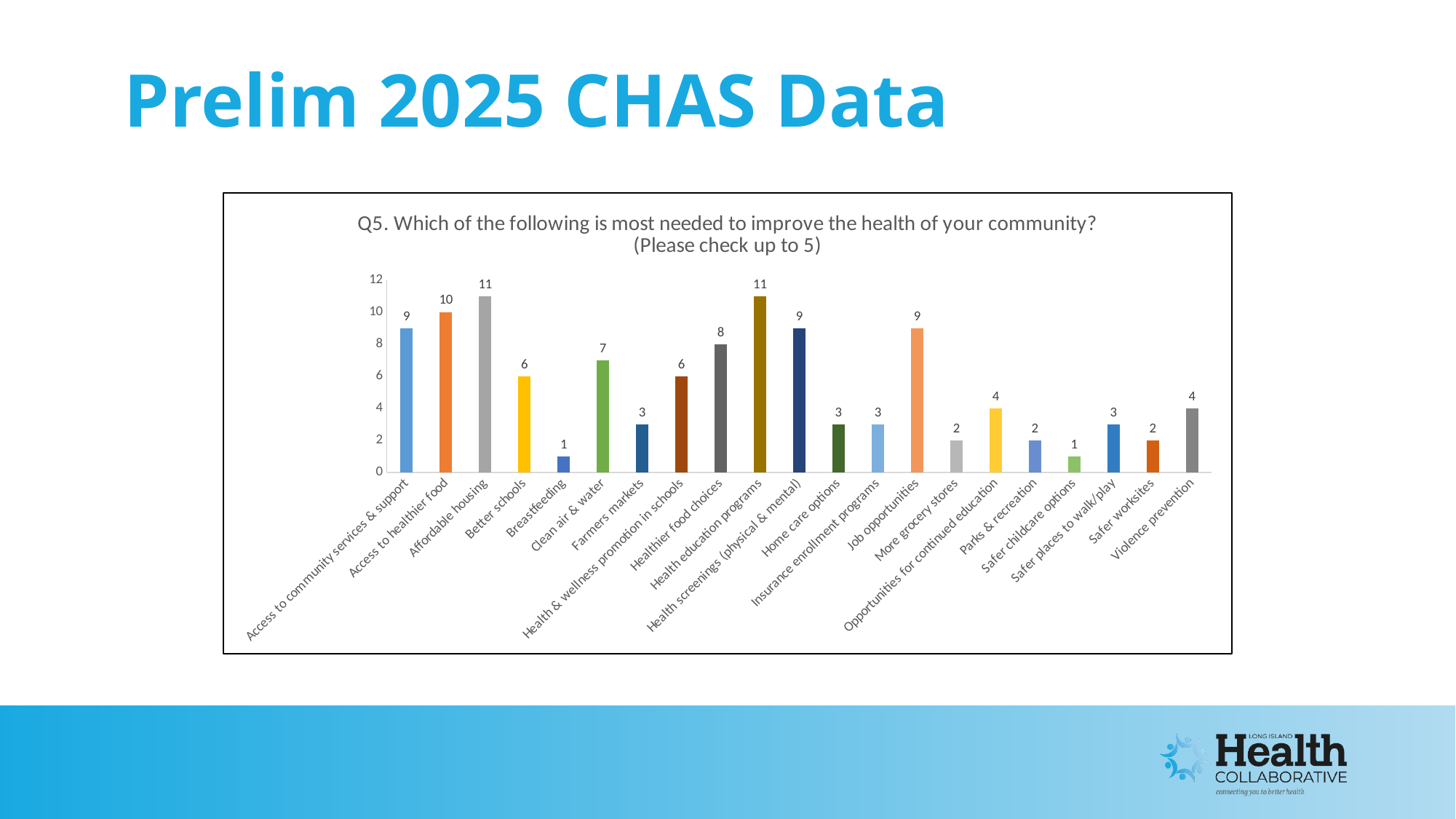
What value is shown for Clean air & water? 7 What is the title of the chart? Q5. Which of the following is most needed to improve the health of your community? (Please check up to 5) How many categories are shown on the chart? 21 Which has a larger value, Healthier food choices or Farmers markets? Healthier food choices What is the difference between the values for Access to healthier food and Better schools? 4 What value is shown for Violence prevention? 4 What kind of chart is shown on the slide? bar chart What is the highest value shown on the chart? 11 What is the lowest value shown on the chart? 1 Is the value for Health screenings (physical & mental) greater or less than 6? greater What value is shown for Affordable housing? 11 What value is shown for Job opportunities? 9